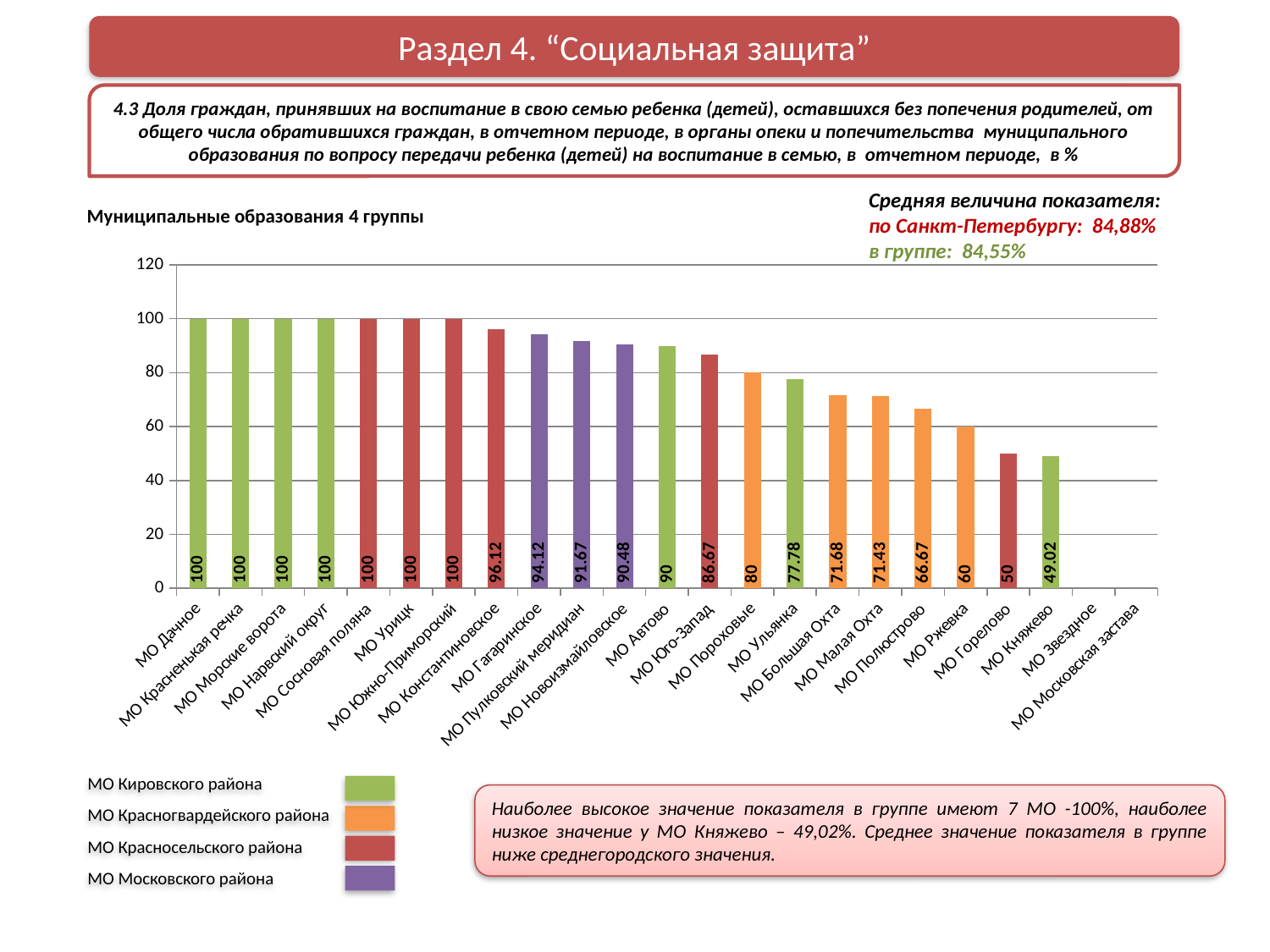
Is the value for МО Горелово greater or less than 60? less What type of chart is shown on the slide? bar chart What is the difference between the values for МО Гагаринское and МО Юго-Запад? 7.45 Do the values rise or fall from left to right along the x axis? fall What is the value for МО Константиновское? 96.12 What is the value for МО Полюстрово? 66.67 How many entries does the legend list? 4 Which municipality with a plotted bar has the lowest value? МО Княжево What is the value for МО Пулковский меридиан? 91.67 What is the difference between the values for МО Пороховые and МО Ржевка? 20 Which is larger, the value for МО Ульянка or the value for МО Большая Охта? МО Ульянка How many municipalities are labelled on the x axis? 23